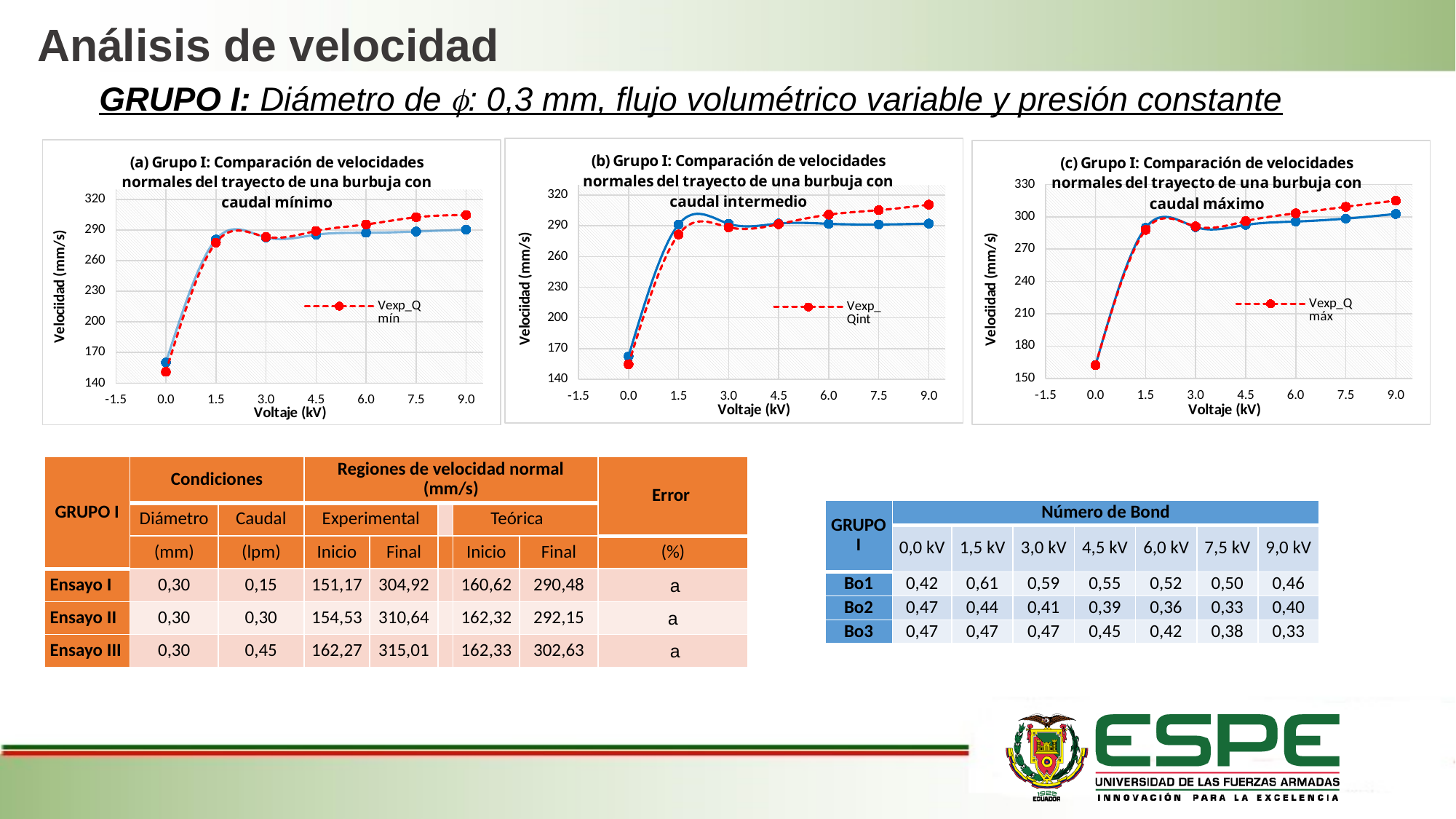
In chart (a) (caudal mínimo), at which voltage is the Vexp_Q mín value highest? 9.0 kV What is the x-axis label of chart (b) (caudal intermedio)? Voltaje (kV) In chart (c) (caudal máximo), is the Vexp_Q máx value at 0.0 kV greater or less than 180? less How many series does the legend of chart (c) (caudal máximo) list? 1 What kind of chart is chart (a), 'Comparación de velocidades normales del trayecto de una burbuja con caudal mínimo'? line chart In chart (a) (caudal mínimo), at which voltage is the Vexp_Q mín value lowest? 0.0 kV In chart (c) (caudal máximo), is the Vexp_Q máx value at 9.0 kV greater or less than 300? greater In chart (b) (caudal intermedio), does the Vexp_Qint series overall rise or fall as voltage increases from 0.0 to 9.0 kV? rise In chart (a) (caudal mínimo), is the Vexp_Q mín value at 9.0 kV greater or less than 290? greater In chart (a) (caudal mínimo), how many data points does the Vexp_Q mín series have? 7